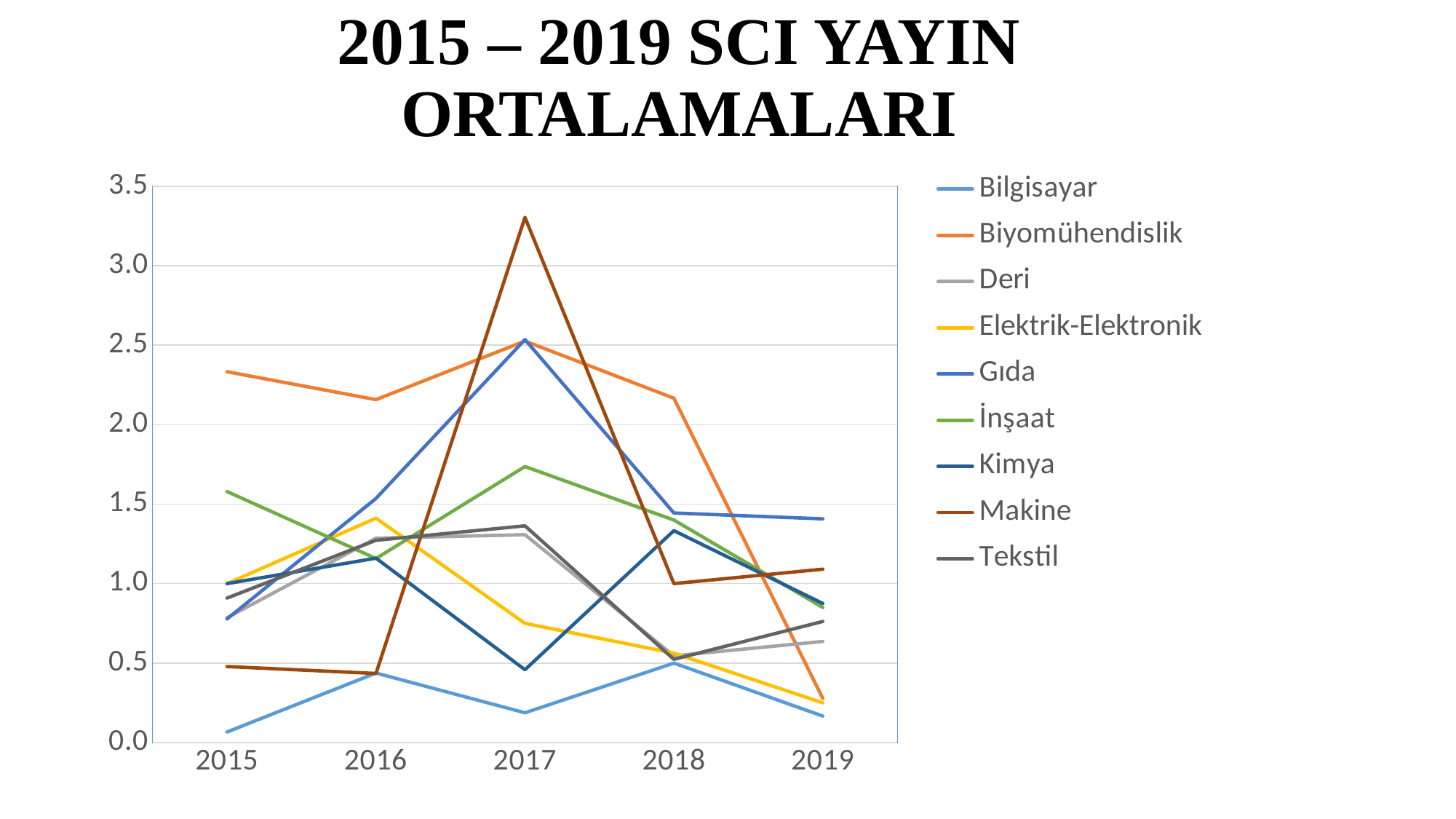
Which series has the highest value in 2017? Makine Is the value for Biyomühendislik in 2015 greater or less than 2.0? greater Does the value for Makine rise or fall from 2017 to 2018? fall How many years are shown along the x axis? 5 In 2019, which is larger: the value for Gıda or the value for Bilgisayar? Gıda What is the title of the chart on the slide? 2015 – 2019 SCI YAYIN ORTALAMALARI How many series does the legend list? 9 What kind of chart is shown on the slide? line chart Is the value for Makine in 2017 greater or less than 3.0? greater Is the value for Bilgisayar in 2015 greater or less than 0.5? less Which series has the highest value in 2015? Biyomühendislik Which series has the lowest value in 2017? Bilgisayar